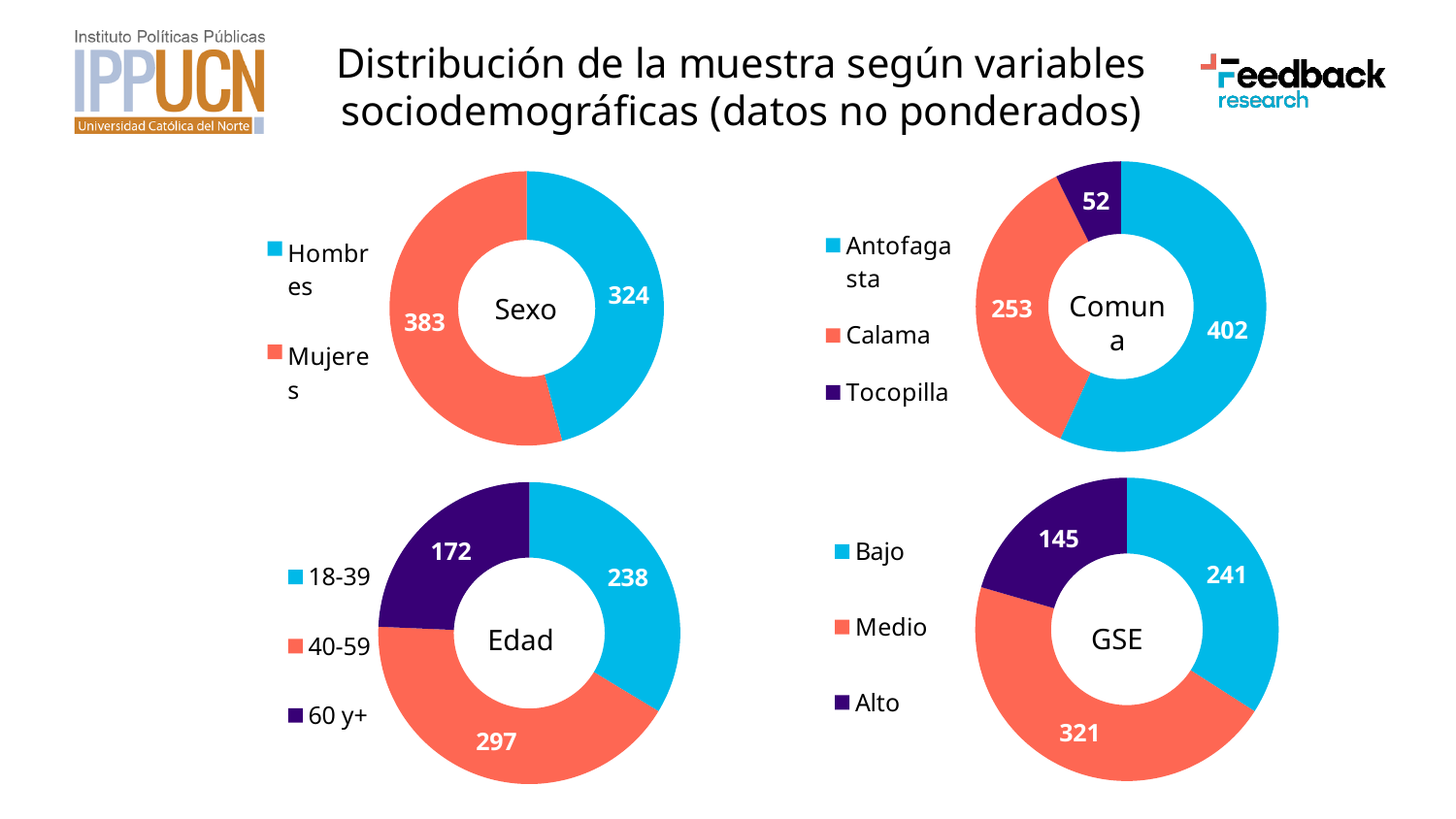
In the GSE chart, which is larger, Bajo or Medio? Medio In the GSE chart, what is the value for Alto? 145 How many charts are shown on the slide? 4 In the Comuna chart, which category has the highest value? Antofagasta In the Sexo chart, what is the value for Mujeres? 383 In the GSE chart, what is the total of all three categories? 707 In the Edad chart, which category has the lowest value? 60 y+ How many categories does the Comuna chart show? 3 In the Comuna chart, what is the value for Tocopilla? 52 In the Edad chart, what is the value for 40-59? 297 In the Sexo chart, what is the difference between Mujeres and Hombres? 59 What kind of chart is the Edad chart? Doughnut chart